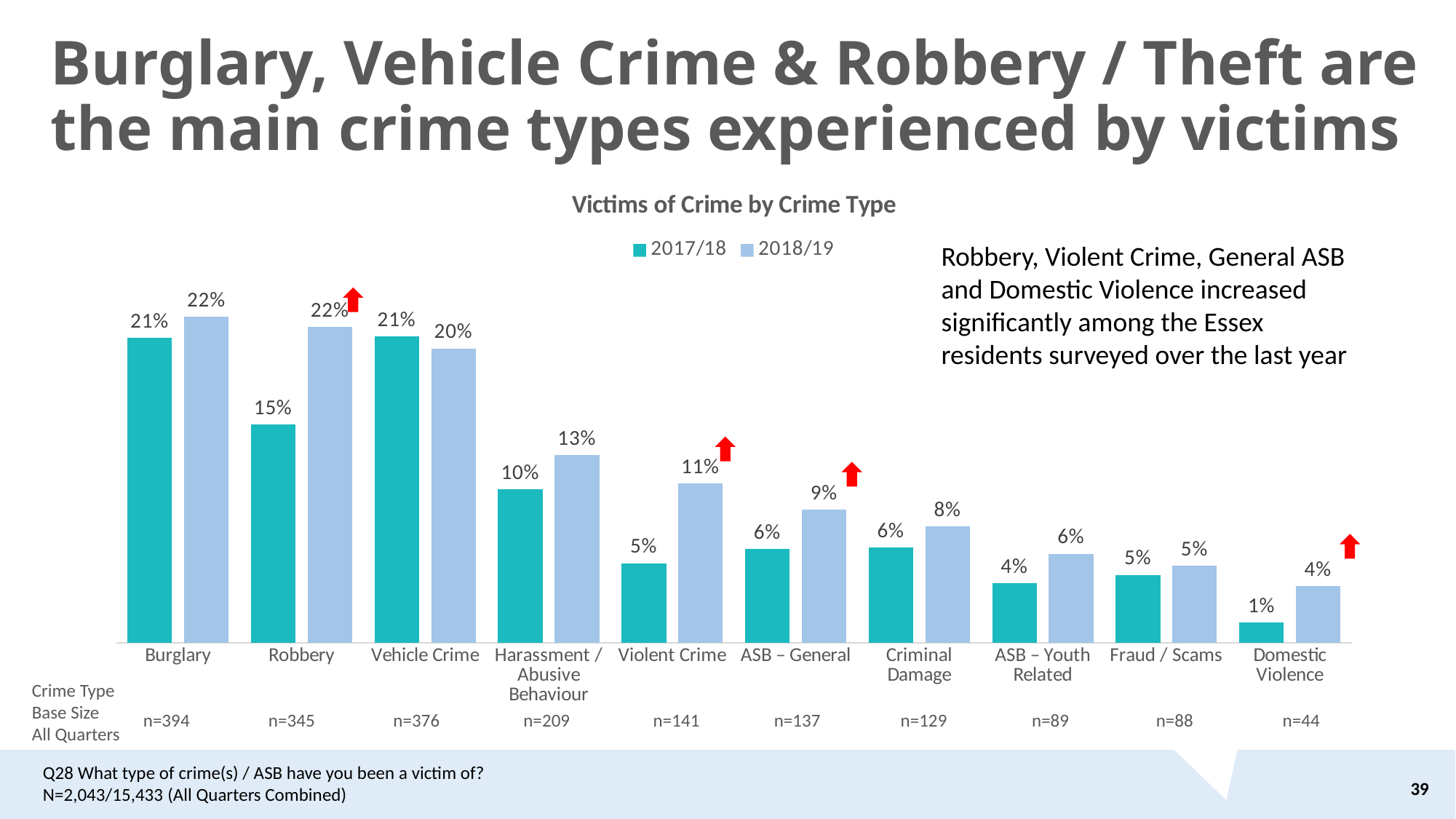
How many crime types are shown on the x axis? 10 What is the 2017/18 value for Harassment / Abusive Behaviour? 10% Which is larger for Vehicle Crime: the 2017/18 value or the 2018/19 value? 2017/18 Which crime type has the lowest value for 2017/18? Domestic Violence What is the difference between the 2017/18 and 2018/19 values for Violent Crime? 6% What kind of chart is shown on the slide? Bar chart Which crime type has the lowest value for 2018/19? Domestic Violence By how many percentage points did Robbery increase from 2017/18 to 2018/19? 7% How many series does the legend list? 2 What is the 2018/19 value for Violent Crime? 11% What percentage of victims experienced Robbery in 2018/19? 22% Which is larger: the 2018/19 value for Criminal Damage or the 2018/19 value for ASB – General? ASB – General